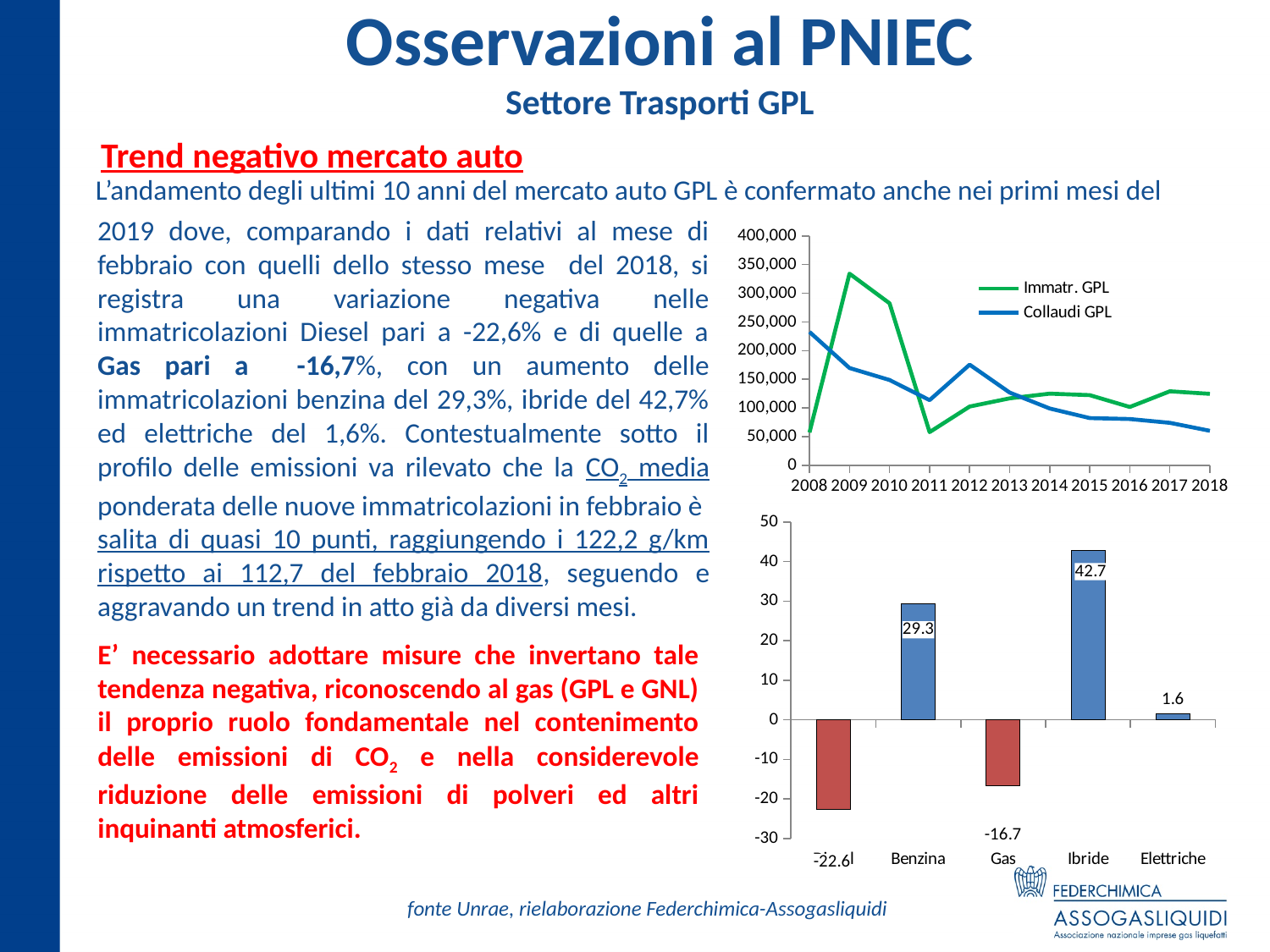
In the bar chart at the bottom right, which category has the highest value? Ibride In the line chart at the top right, is the value of Collaudi GPL in 2018 greater or less than 100,000? less In the line chart at the top right, is the value of Immatr. GPL in 2009 greater or less than 300,000? greater In the line chart at the top right, in which year does Immatr. GPL reach its highest value? 2009 In the line chart at the top right, does Collaudi GPL generally rise or fall from 2008 to 2018? fall In the line chart at the top right, how many years are shown on the x axis? 11 In the line chart at the top right, which series has the higher value in 2008, Immatr. GPL or Collaudi GPL? Collaudi GPL In the bar chart at the bottom right, what is the value for Ibride? 42.7 In the bar chart at the bottom right, what is the difference between the values for Ibride and Benzina? 13.4 In the line chart at the top right, what are the two series named in the legend? Immatr. GPL and Collaudi GPL In the line chart at the top right, how many series does the legend list? 2 In the bar chart at the bottom right, what is the value for Gas? -16.7